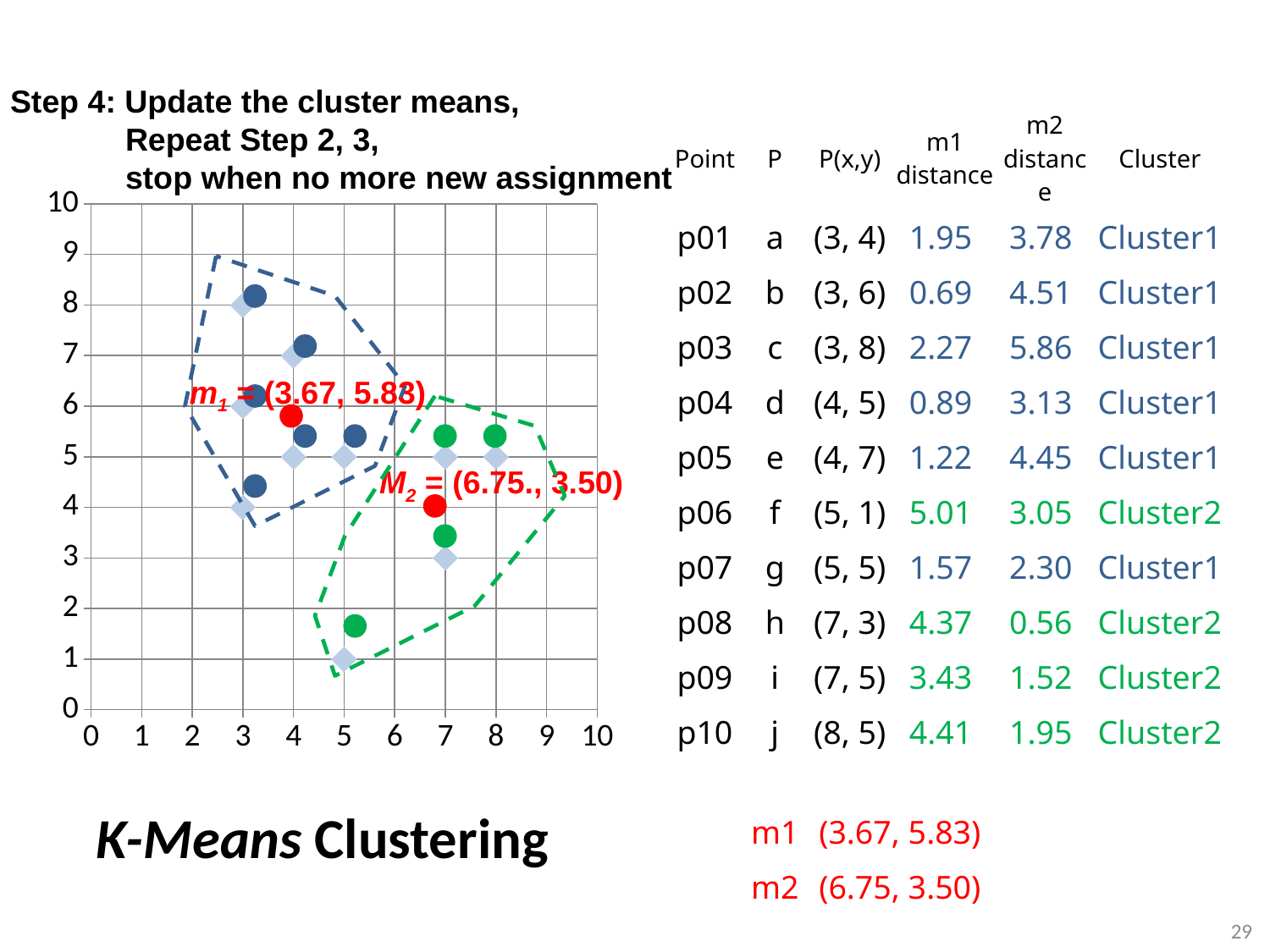
Which cluster mean has the larger x coordinate, m1 or M2? M2 Which plotted data point has the highest y value on the chart? (3, 8) How many diamond-shaped data points are plotted on the chart? 10 What are the coordinates of the cluster mean m1 labelled on the chart? (3.67, 5.83) Is the x coordinate of the cluster mean M2 greater or less than 6? greater What kind of chart is shown on the left of the slide? scatter chart Which plotted data point has the lowest y value on the chart? (5, 1) What are the coordinates of the cluster mean M2 labelled on the chart? (6.75, 3.50) Is the y coordinate of the cluster mean m1 greater or less than 5? greater What is the highest value shown on the chart's y axis? 10 Which cluster mean has the larger y coordinate, m1 or M2? m1 What is the difference between the x coordinates of M2 and m1? 3.08